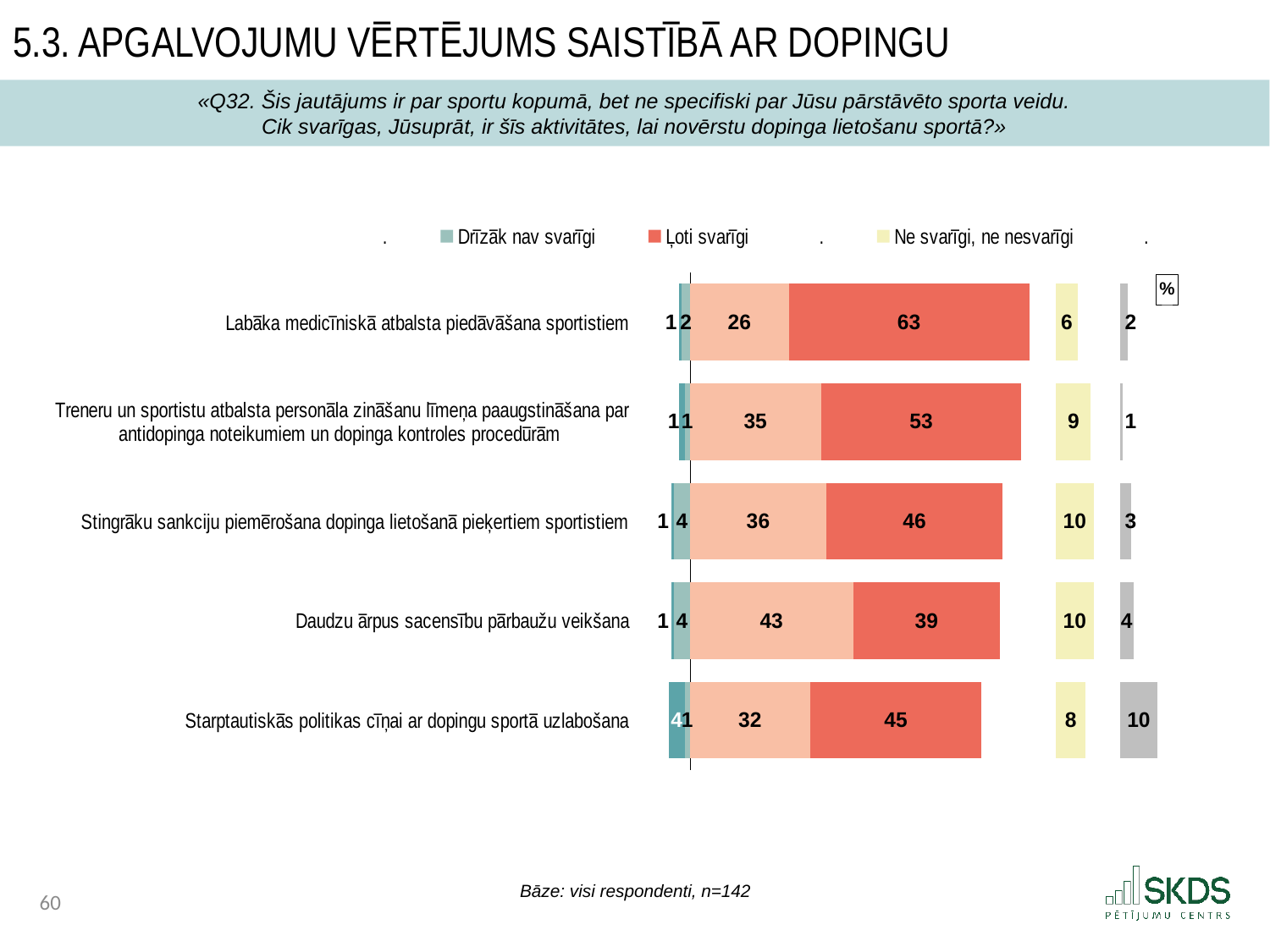
What is the 'Ļoti svarīgi' value for 'Labāka medicīniskā atbalsta piedāvāšana sportistiem'? 63 Which category has the lowest 'Ļoti svarīgi' value? Daudzu ārpus sacensību pārbaužu veikšana Which category has the highest 'Ļoti svarīgi' value? Labāka medicīniskā atbalsta piedāvāšana sportistiem What is the 'Ļoti svarīgi' value for 'Stingrāku sankciju piemērošana dopinga lietošanā pieķertiem sportistiem'? 46 Which category has the lowest 'Ne svarīgi, ne nesvarīgi' value? Labāka medicīniskā atbalsta piedāvāšana sportistiem How many categories (statements) are shown in the chart? 5 What is the 'Ne svarīgi, ne nesvarīgi' value for 'Starptautiskās politikas cīņai ar dopingu sportā uzlabošana'? 8 What is the 'Ļoti svarīgi' value for 'Daudzu ārpus sacensību pārbaužu veikšana'? 39 What is the difference between the 'Ļoti svarīgi' values for 'Labāka medicīniskā atbalsta piedāvāšana sportistiem' and 'Treneru un sportistu atbalsta personāla zināšanu līmeņa paaugstināšana par antidopinga noteikumiem un dopinga kontroles procedūrām'? 10 What kind of chart is shown on the slide? Stacked bar chart Which legend entry is shown in red? Ļoti svarīgi Which has the larger 'Ļoti svarīgi' value: 'Starptautiskās politikas cīņai ar dopingu sportā uzlabošana' or 'Daudzu ārpus sacensību pārbaužu veikšana'? Starptautiskās politikas cīņai ar dopingu sportā uzlabošana